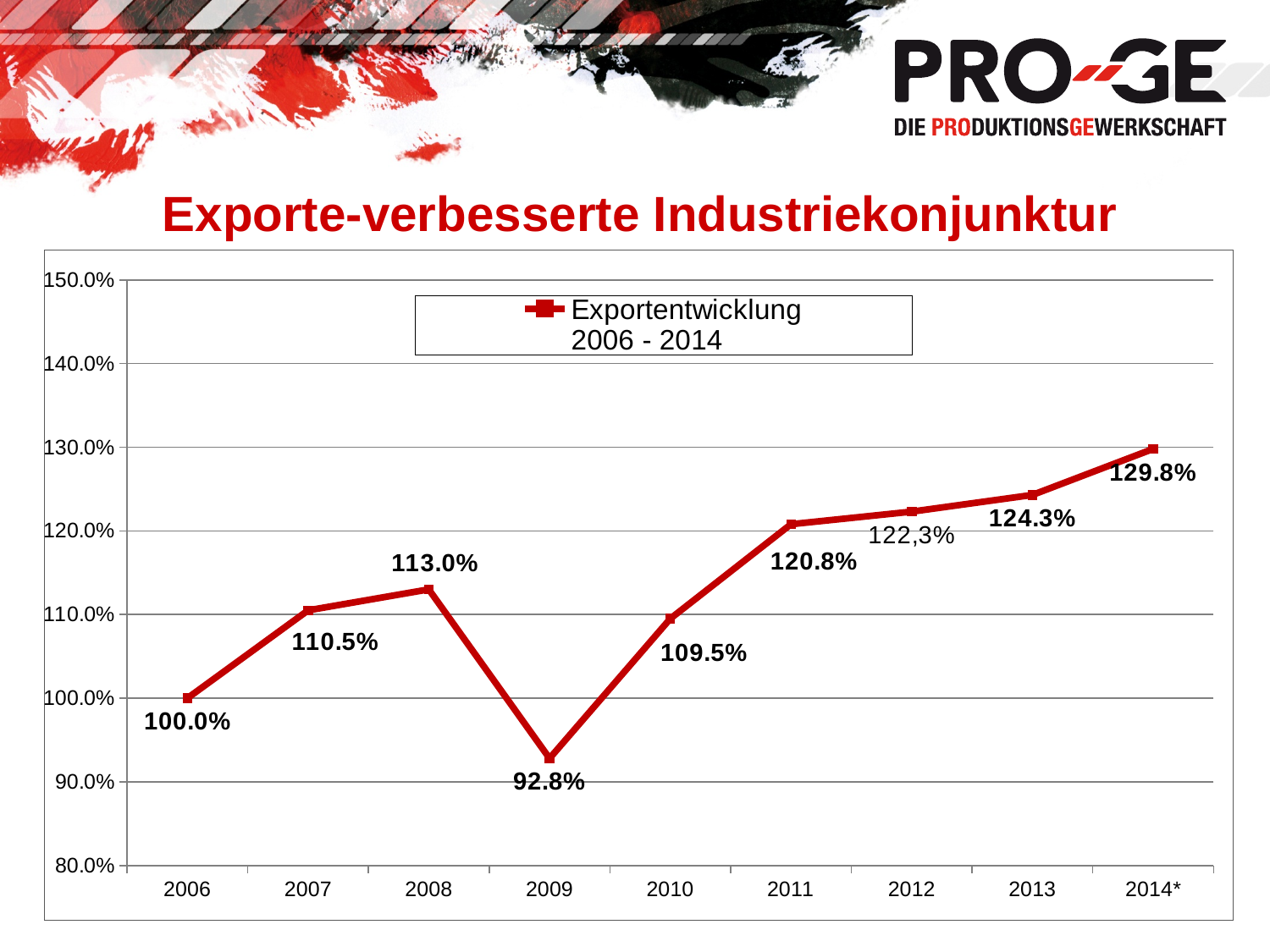
Is the value for 2013 greater or less than 120.0%? greater What is the value for 2014*? 129.8% Which year has the highest value? 2014* What kind of chart is shown? line chart What is the value for 2007? 110.5% Which year has the lowest value? 2009 What is the legend entry for the plotted series? Exportentwicklung 2006 - 2014 What is the value for 2009? 92.8% What is the difference between the values for 2008 and 2009? 20.2% How many years are shown on the x axis? 9 Which is larger, the value for 2010 or the value for 2007? 2007 What is the value for 2011? 120.8%